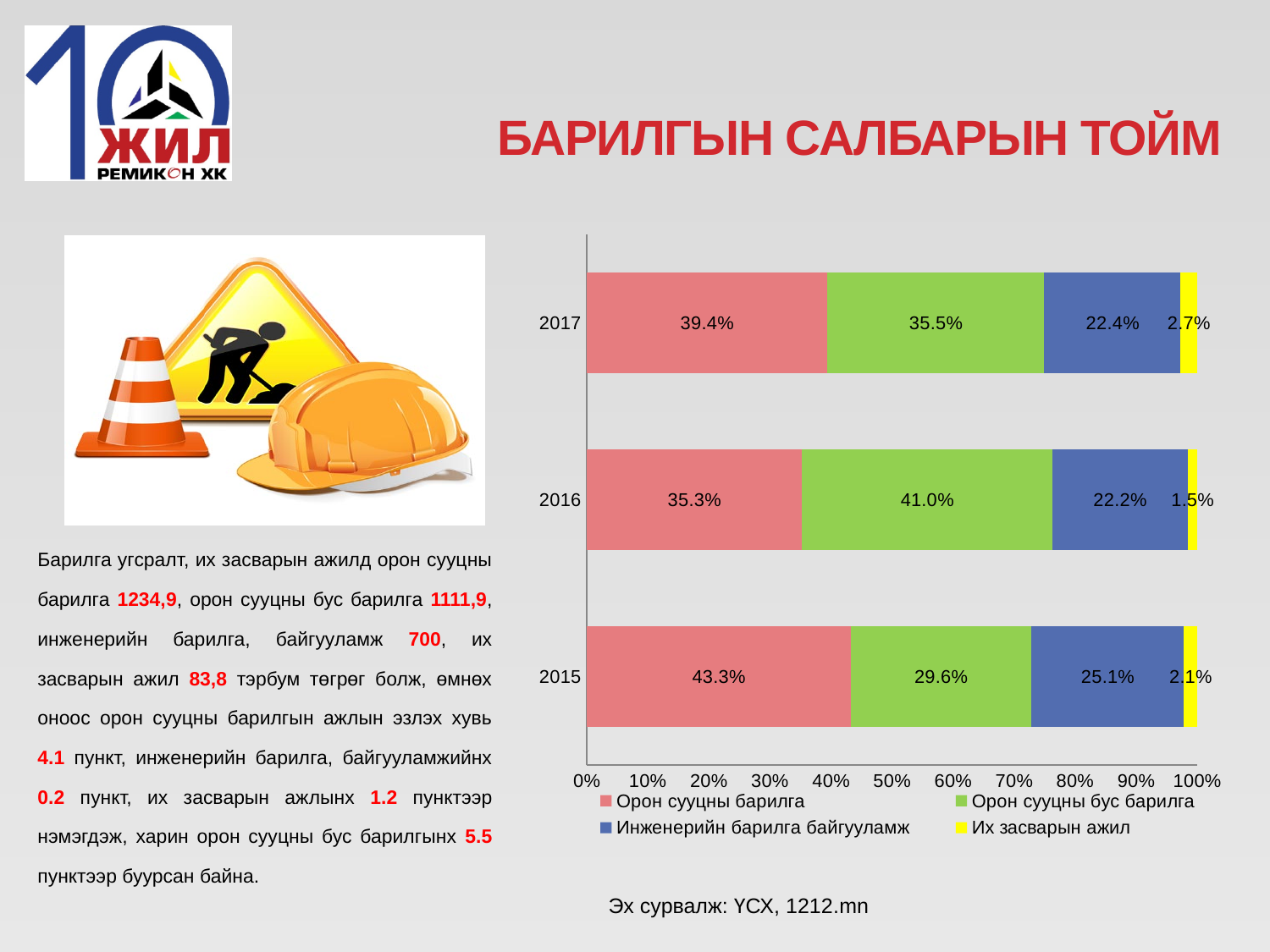
In which year is the share of Их засварын ажил the lowest? 2016 What kind of chart is shown on the slide? Stacked bar chart How many series does the legend list? 4 What is the difference between the Орон сууцны бус барилга values for 2016 and 2015? 11.4 percentage points What is the value for Инженерийн барилга байгууламж in 2015? 25.1% Does the share of Орон сууцны барилга rise or fall from 2015 to 2016? Fall How many years are shown on the chart? 3 In which year is the share of Орон сууцны барилга the highest? 2015 What is the value for Их засварын ажил in 2016? 1.5% What colour represents Их засварын ажил in the chart? Yellow In 2017, which is larger: Орон сууцны барилга or Орон сууцны бус барилга? Орон сууцны барилга What is the value for Орон сууцны барилга in 2017? 39.4%